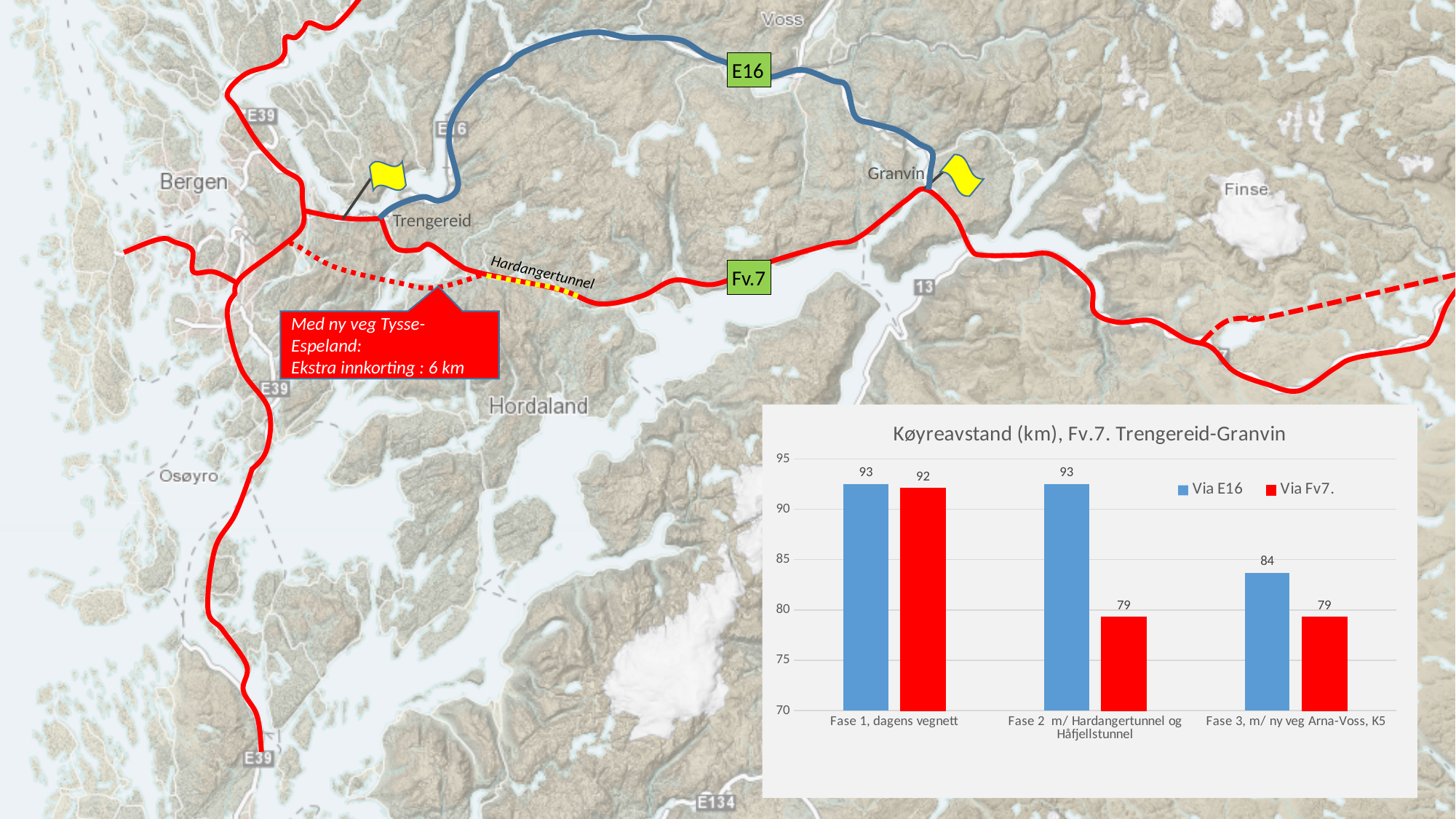
What is the value for Via Fv7. in Fase 1, dagens vegnett? 92 What is the value for Via E16 in Fase 1, dagens vegnett? 93 Which is larger in Fase 3, m/ ny veg Arna-Voss, K5: Via E16 or Via Fv7.? Via E16 What is the difference between Via E16 and Via Fv7. in Fase 3, m/ ny veg Arna-Voss, K5? 5 What is the difference between Via E16 and Via Fv7. in Fase 2 m/ Hardangertunnel og Håfjellstunnel? 14 What is the title of the chart? Køyreavstand (km), Fv.7. Trengereid-Granvin What kind of chart is shown on the slide? bar chart How many categories are shown on the x axis of the chart? 3 What is the value for Via Fv7. in Fase 2 m/ Hardangertunnel og Håfjellstunnel? 79 Which category has the lowest value for Via E16? Fase 3, m/ ny veg Arna-Voss, K5 How many series does the chart legend list? 2 What is the value for Via E16 in Fase 3, m/ ny veg Arna-Voss, K5? 84